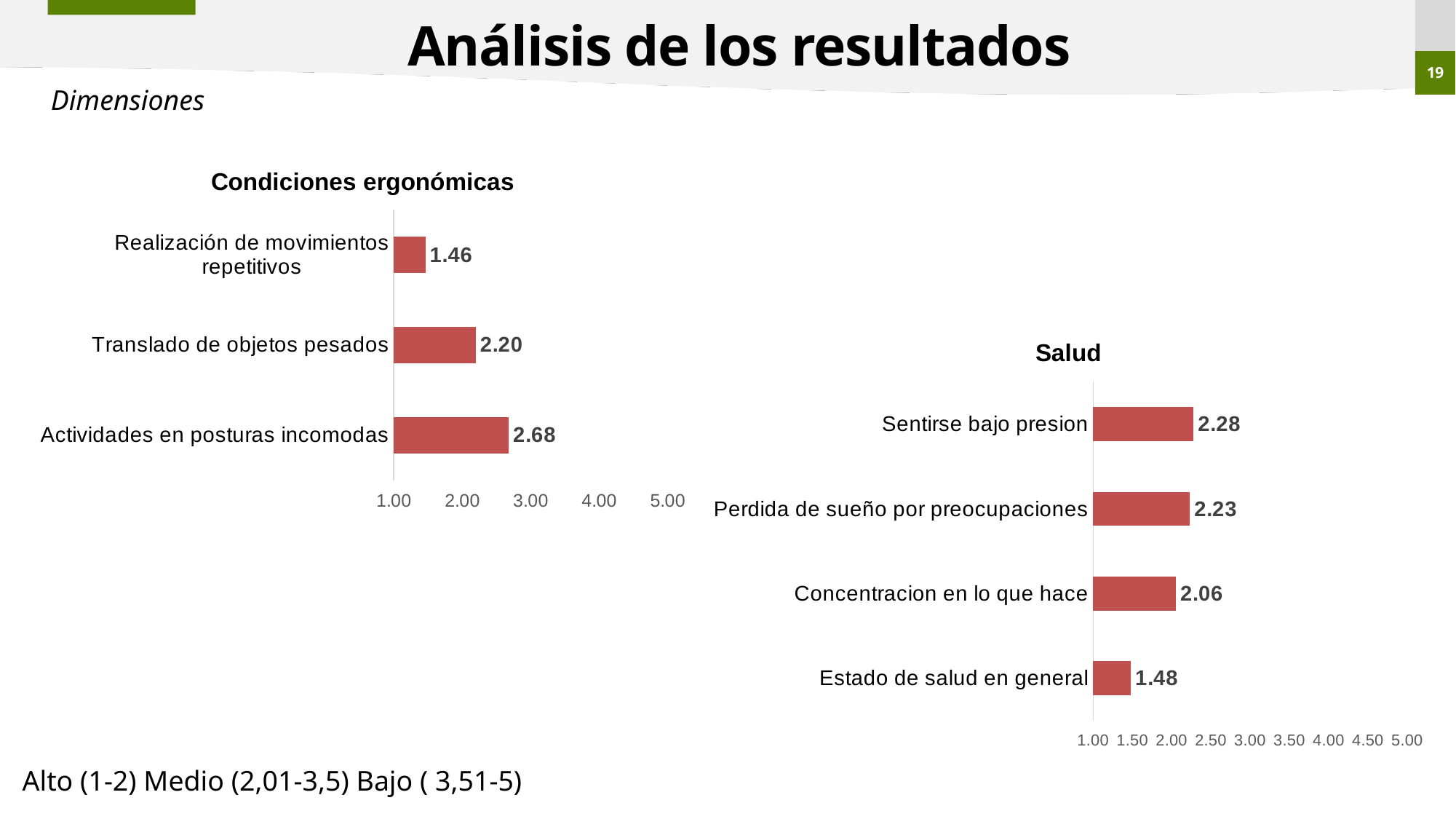
In the 'Salud' chart, how many categories are shown? 4 In the 'Salud' chart, what is the value for 'Concentracion en lo que hace'? 2.06 In the 'Salud' chart, what is the difference between 'Sentirse bajo presion' and 'Estado de salud en general'? 0.80 In the 'Condiciones ergonómicas' chart, what is the value for 'Translado de objetos pesados'? 2.20 In the 'Condiciones ergonómicas' chart, what is the difference between 'Actividades en posturas incomodas' and 'Realización de movimientos repetitivos'? 1.22 In the 'Condiciones ergonómicas' chart, which category has the lowest value? Realización de movimientos repetitivos In the 'Condiciones ergonómicas' chart, how many categories are shown? 3 In the 'Condiciones ergonómicas' chart, which category has the highest value? Actividades en posturas incomodas What kind of chart is the 'Salud' chart? Bar chart In the 'Salud' chart, which category has the highest value? Sentirse bajo presion In the 'Salud' chart, which category has the lowest value? Estado de salud en general In the 'Salud' chart, is the value for 'Perdida de sueño por preocupaciones' greater or less than 2.00? greater